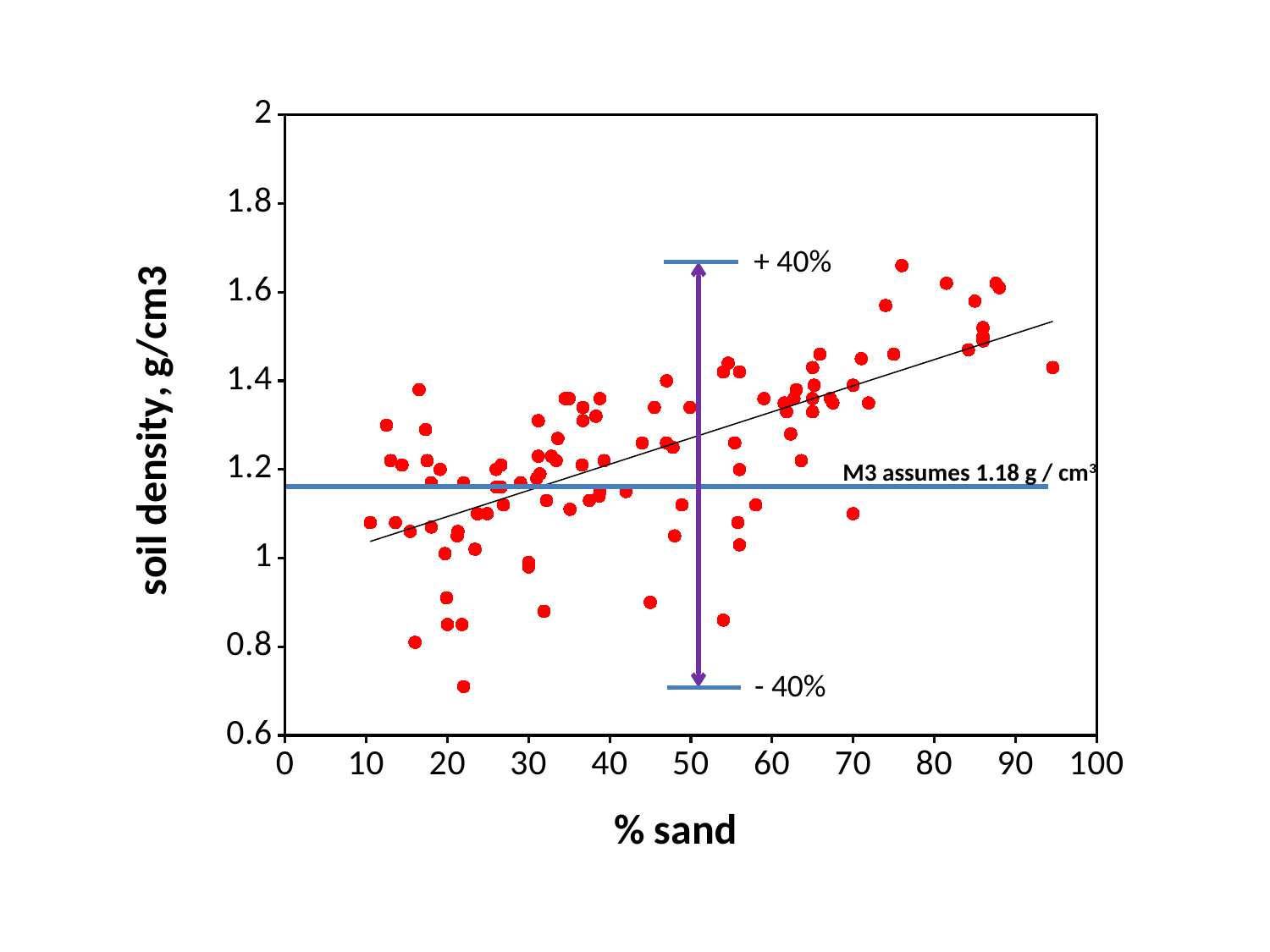
Is the soil density of the point plotted at about 10% sand greater or less than 1? greater What kind of chart is shown on the slide? scatter chart What is the label on the y axis? soil density, g/cm3 What two percentage labels are shown at the ends of the vertical purple arrow? + 40% and - 40% As % sand increases along the x axis, does soil density generally rise or fall? rise What soil density does the annotation say M3 assumes? 1.18 g / cm³ Is the lowest plotted soil density value greater or less than 0.8? less Is the highest plotted soil density value greater or less than 1.6? greater